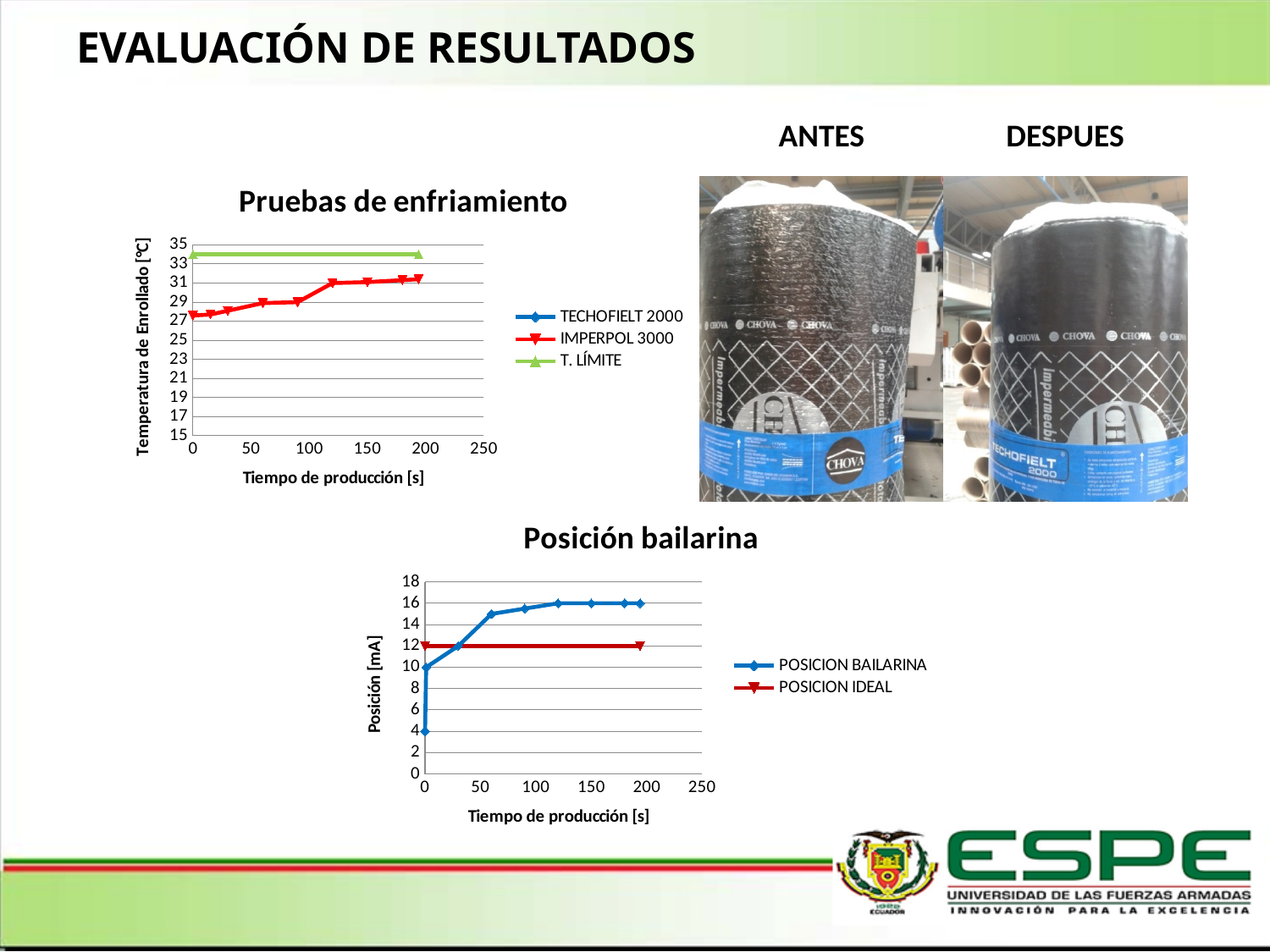
In the chart titled "Pruebas de enfriamiento", what kind of chart is shown? Line chart In the chart titled "Pruebas de enfriamiento", is the value of T. LÍMITE greater or less than 31? greater In the chart titled "Pruebas de enfriamiento", how many series does the legend list? 3 In the chart titled "Posición bailarina", what is the value of POSICION IDEAL? 12 In the chart titled "Posición bailarina", what kind of chart is shown? Line chart In the chart titled "Pruebas de enfriamiento", what are the legend entries? TECHOFIELT 2000, IMPERPOL 3000, T. LÍMITE In the chart titled "Pruebas de enfriamiento", at 150 s, which is larger: T. LÍMITE or IMPERPOL 3000? T. LÍMITE In the chart titled "Pruebas de enfriamiento", does the IMPERPOL 3000 series rise or fall as time increases? Rises In the chart titled "Posición bailarina", how many series does the legend list? 2 In the chart titled "Posición bailarina", how does POSICION BAILARINA change as time increases? Rises, then levels off In the chart titled "Posición bailarina", is the value of POSICION BAILARINA at 200 s greater or less than 14? greater In the chart titled "Posición bailarina", at 200 s, which is larger: POSICION BAILARINA or POSICION IDEAL? POSICION BAILARINA